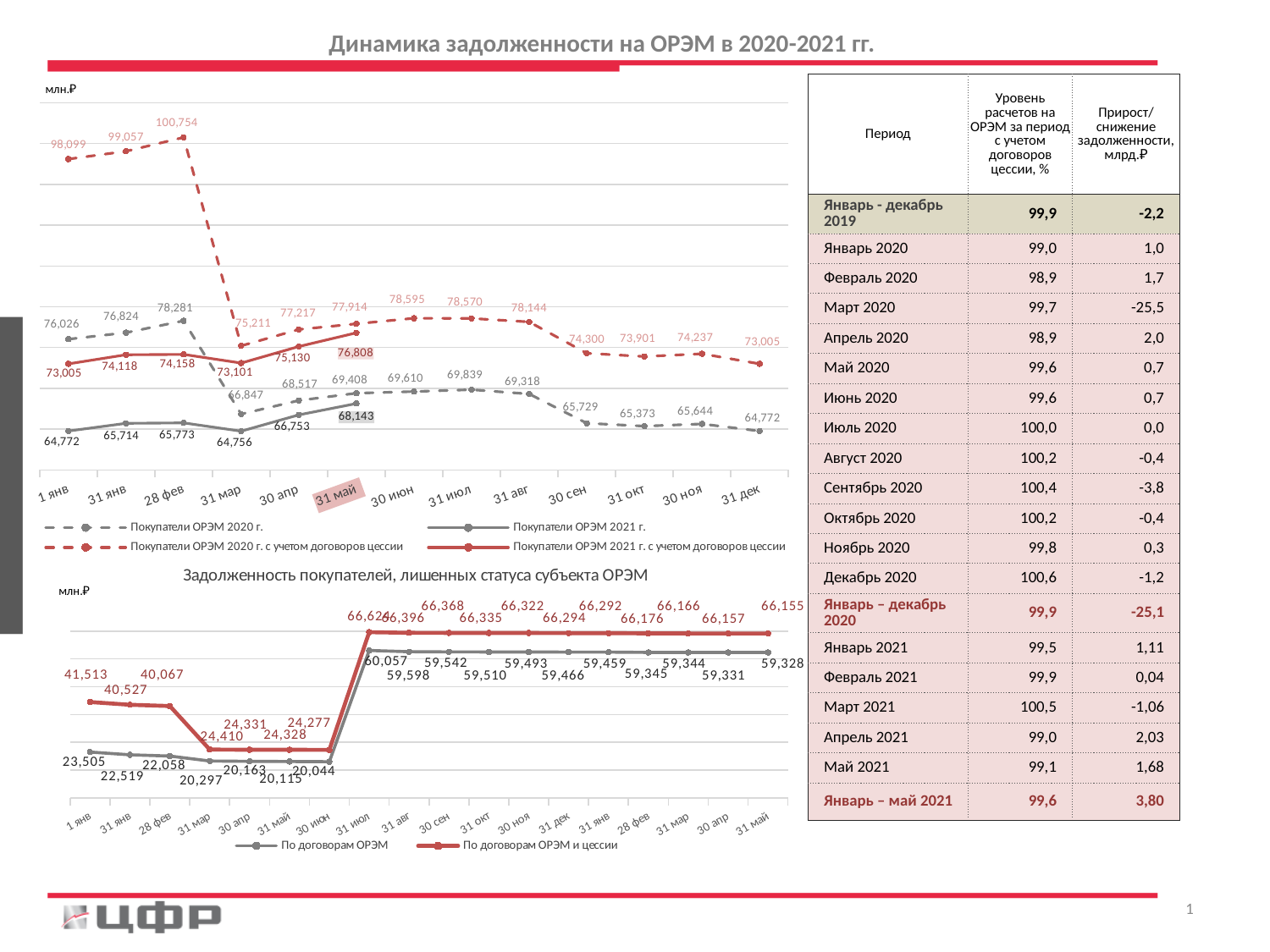
On the bottom chart, which series has the larger value on 31 июл: По договорам ОРЭМ or По договорам ОРЭМ и цессии? По договорам ОРЭМ и цессии What kind of chart is the top chart? Line chart On the bottom chart, what is the value for По договорам ОРЭМ и цессии on 1 янв? 41,513 On the top chart, does the Покупатели ОРЭМ 2021 г. с учетом договоров цессии series rise or fall from 31 мар to 31 май? Rises On the bottom chart, what is the lowest value of the По договорам ОРЭМ series? 20,044 How many series does the legend of the bottom chart (Задолженность покупателей, лишенных статуса субъекта ОРЭМ) list? 2 On the top chart, what is the highest value of the Покупатели ОРЭМ 2020 г. с учетом договоров цессии series? 100,754 On the top chart, what is the difference between Покупатели ОРЭМ 2021 г. с учетом договоров цессии and Покупатели ОРЭМ 2021 г. on 31 май? 8,665 On the bottom chart, what is the difference between По договорам ОРЭМ и цессии and По договорам ОРЭМ at the last point (31 май)? 6,827 On the top chart, what is the value for Покупатели ОРЭМ 2021 г. с учетом договоров цессии on 31 май? 76,808 How many series does the legend of the top chart list? 4 On the top chart, what is the value for Покупатели ОРЭМ 2020 г. с учетом договоров цессии on 28 фев? 100,754